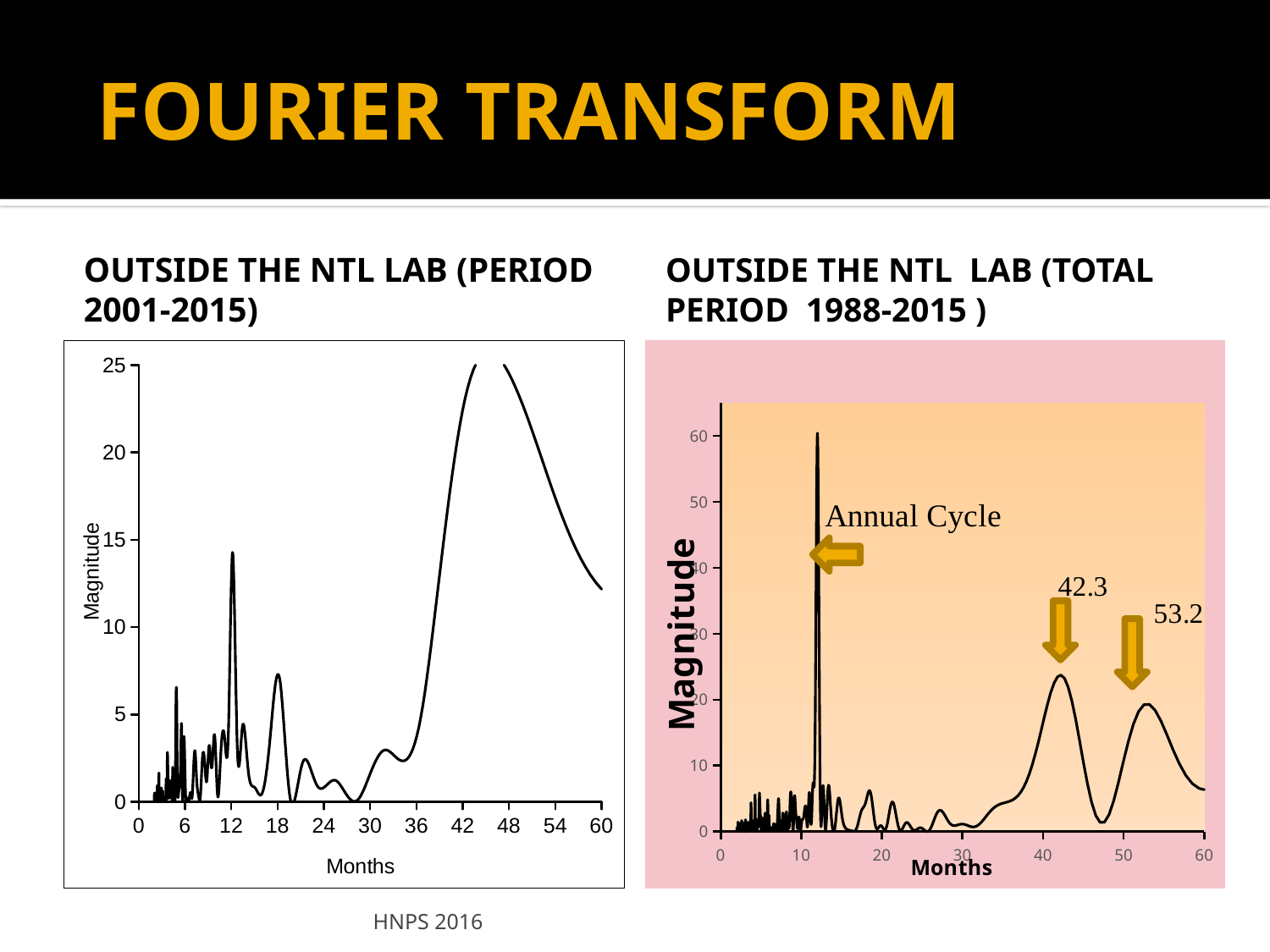
In the left chart (PERIOD 2001-2015), is the magnitude of the peak near 12 months greater or less than 10? greater In the right chart (TOTAL PERIOD 1988-2015), what text labels the tall narrow peak near 12 months? Annual Cycle In the left chart (PERIOD 2001-2015), what is the label of the y axis? Magnitude In the left chart (PERIOD 2001-2015), is the magnitude at 60 months greater or less than 10? greater In the right chart (TOTAL PERIOD 1988-2015), what is the label of the x axis? Months What kind of chart is shown under the title 'OUTSIDE THE NTL LAB (TOTAL PERIOD 1988-2015)'? Line chart What kind of chart is shown under the title 'OUTSIDE THE NTL LAB (PERIOD 2001-2015)'? Line chart In the right chart (TOTAL PERIOD 1988-2015), at what month value is the peak labelled with the first downward arrow? 42.3 In the right chart (TOTAL PERIOD 1988-2015), is the magnitude of the peak at 42.3 months greater or less than 30? less In the right chart (TOTAL PERIOD 1988-2015), at what month value is the peak labelled with the second downward arrow? 53.2 In the right chart (TOTAL PERIOD 1988-2015), which is larger: the magnitude of the Annual Cycle peak or the magnitude of the peak at 42.3 months? Annual Cycle peak